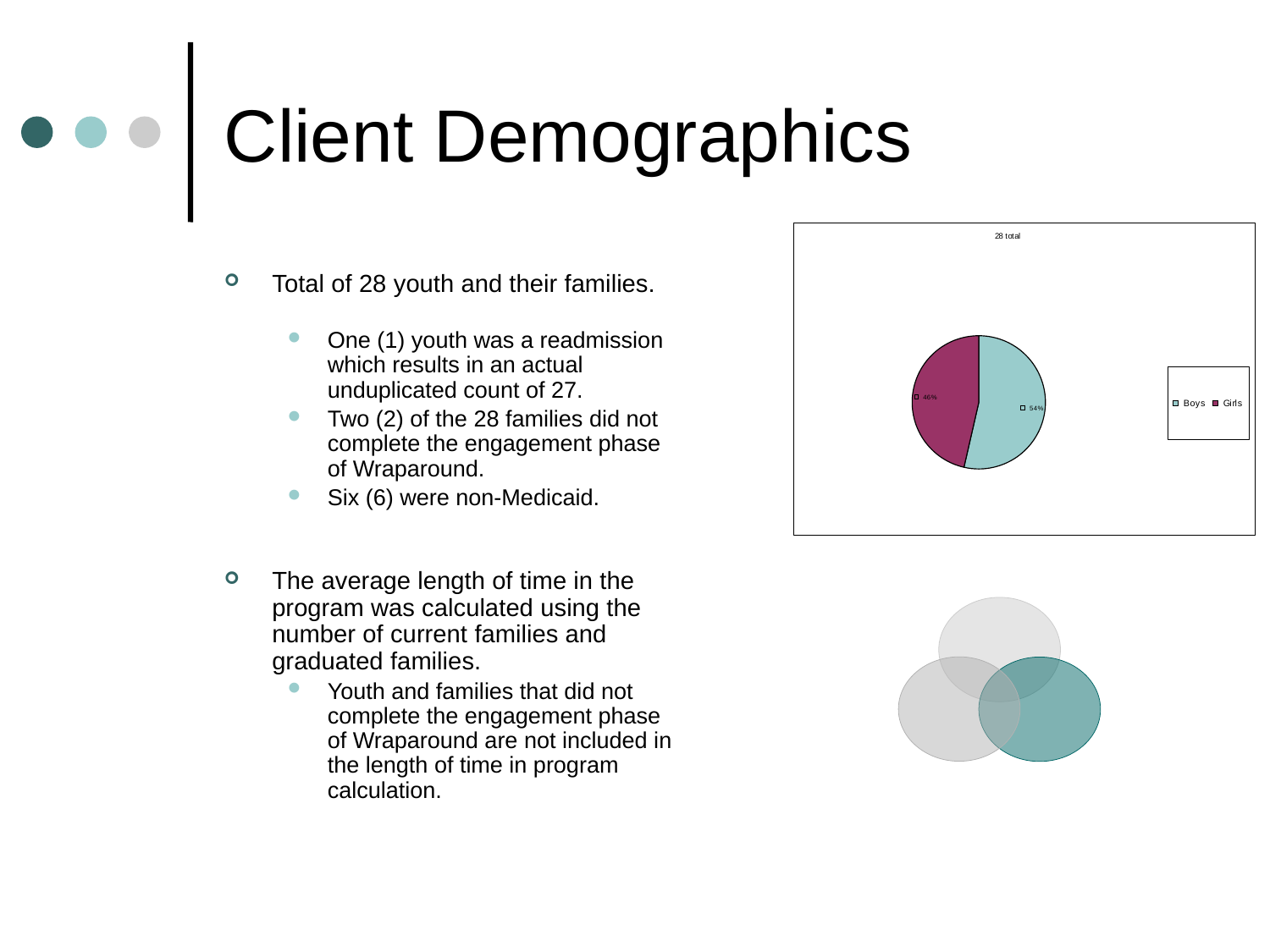
Which slice of the pie chart is the smallest? Girls Which is larger in the pie chart, Boys or Girls? Boys What percentage of the pie chart is Boys? 54% What share of the pie does the Girls slice represent? 46% Which legend entry in the pie chart is shown in the dark magenta colour? Girls Which slice of the pie chart is the largest? Boys What percentage of the pie chart is Girls? 46% What is the difference in percentage points between the Boys and Girls slices? 8 How many entries does the pie chart legend list? 2 How many slices does the pie chart have? 2 What is the title of the pie chart? 28 total What kind of chart is shown on the slide? pie chart